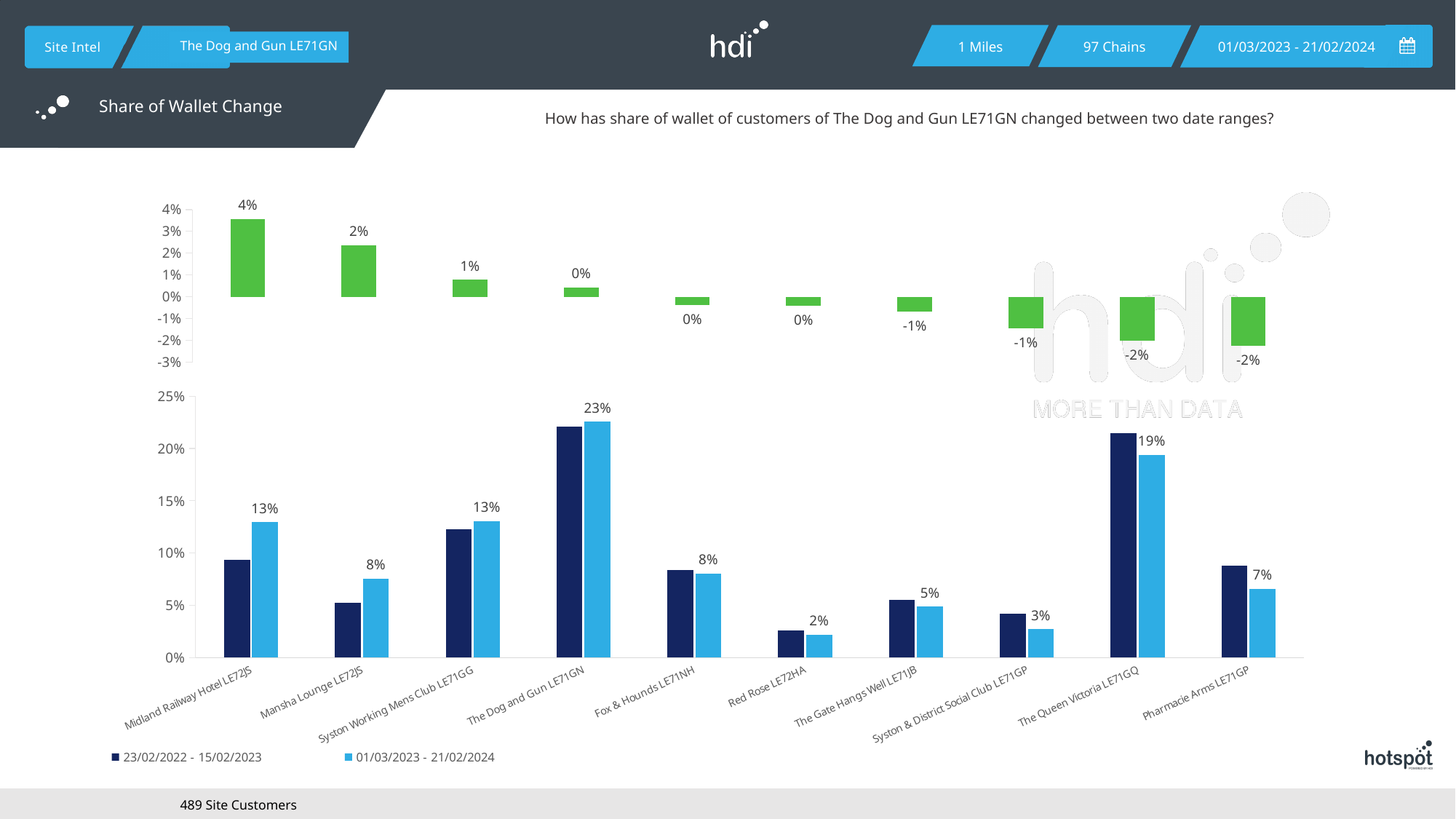
In the top chart (share of wallet change), what is the value for The Queen Victoria LE71GQ? -2% How many categories are shown on the x axis of the bottom chart? 10 In the bottom chart, what is the 01/03/2023 - 21/02/2024 value for The Dog and Gun LE71GN? 23% In the top chart (share of wallet change), what is the value for Midland Railway Hotel LE72JS? 4% In the bottom chart, which category has the lowest 01/03/2023 - 21/02/2024 value? Red Rose LE72HA In the bottom chart, what is the difference between the 01/03/2023 - 21/02/2024 values for The Dog and Gun LE71GN and The Queen Victoria LE71GQ? 4% In the bottom chart, what is the 01/03/2023 - 21/02/2024 value for Red Rose LE72HA? 2% How many series does the legend of the bottom chart list? 2 In the bottom chart, is the 23/02/2022 - 15/02/2023 value for The Queen Victoria LE71GQ greater or less than 20%? greater In the top chart (share of wallet change), which category has the highest value? Midland Railway Hotel LE72JS In the bottom chart, is the 23/02/2022 - 15/02/2023 value for Midland Railway Hotel LE72JS greater or less than 10%? less In the bottom chart, which category has the highest 01/03/2023 - 21/02/2024 value? The Dog and Gun LE71GN